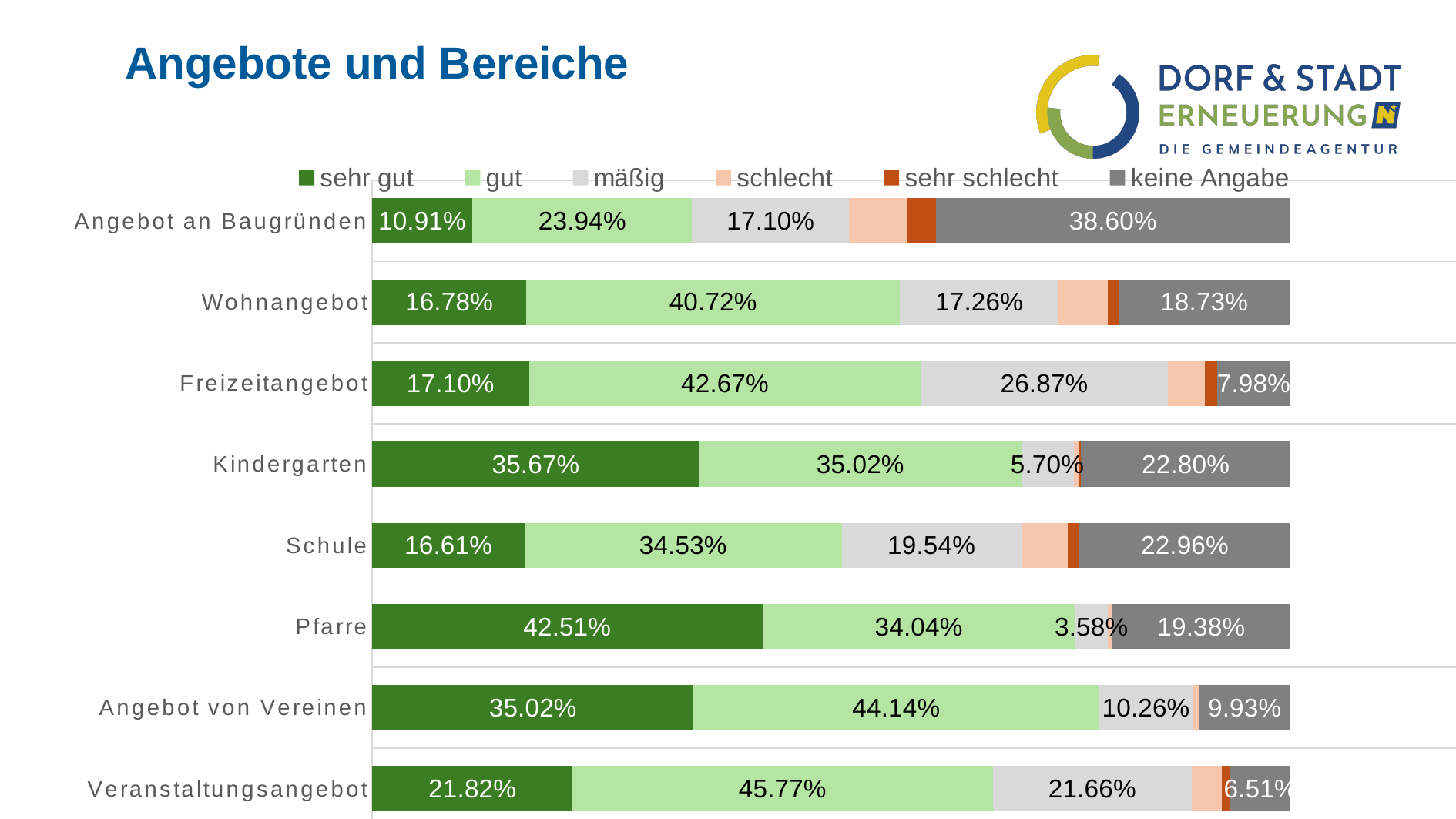
What is the 'keine Angabe' value for Angebot an Baugründen? 38.60% Which has the larger 'gut' value: Freizeitangebot or Angebot von Vereinen? Angebot von Vereinen For Wohnangebot, what is the difference between the 'gut' value and the 'sehr gut' value? 23.94% How many categories are shown on the chart? 8 What is the 'mäßig' value for Freizeitangebot? 26.87% What is the 'sehr gut' value for Pfarre? 42.51% How many series does the legend list? 6 Which category has the highest 'sehr gut' value? Pfarre What kind of chart is shown on the slide? Stacked bar chart Which category has the lowest 'sehr gut' value? Angebot an Baugründen Which category has the highest 'keine Angabe' value? Angebot an Baugründen What is the 'gut' value for Veranstaltungsangebot? 45.77%